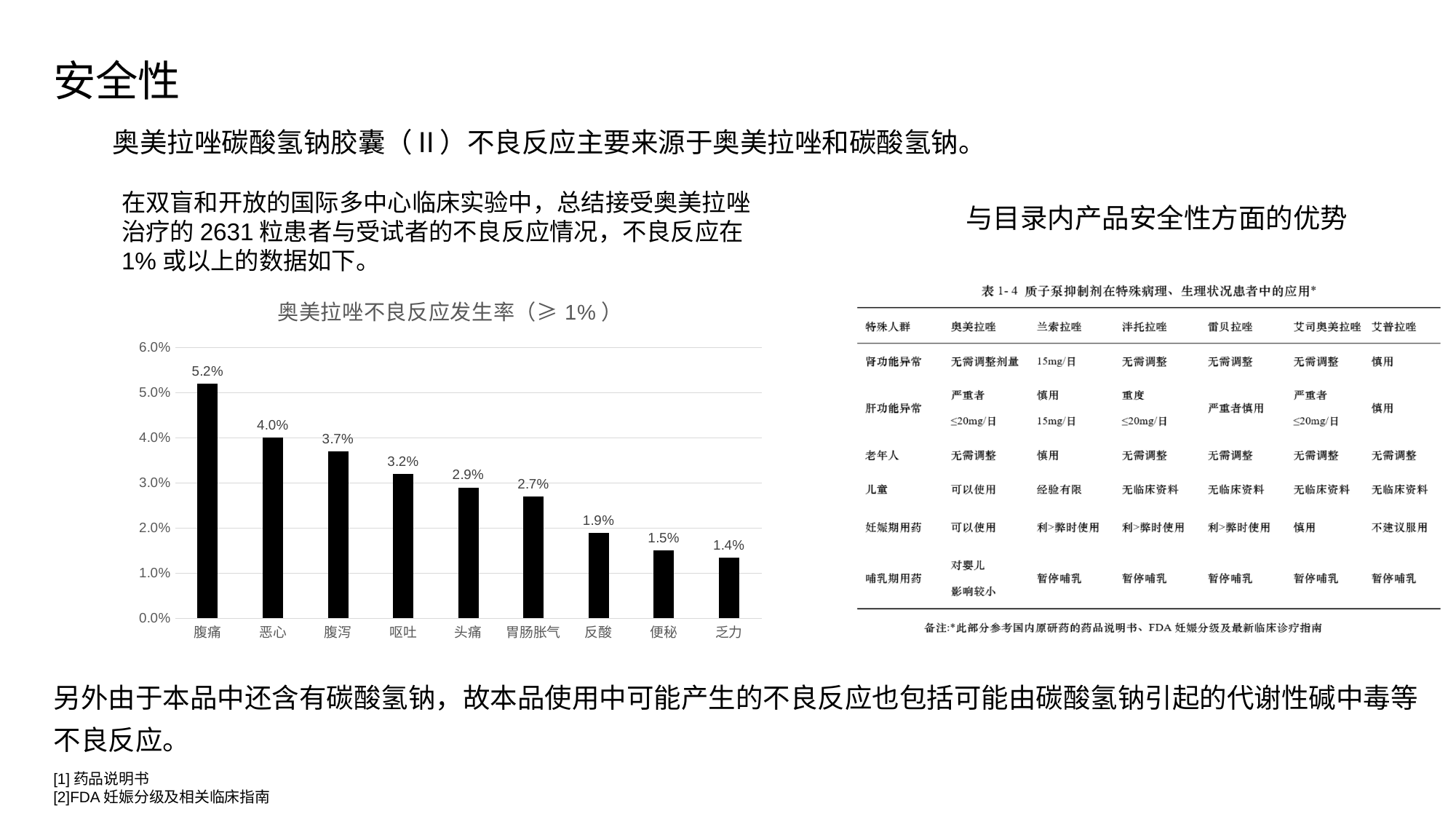
Which adverse reaction has the lowest incidence rate in the chart? 乏力 What is the difference between the incidence rates for 腹痛 and 恶心? 1.2% What is the difference between the incidence rates for 呕吐 and 反酸? 1.3% What is the incidence rate for 头痛 in the chart? 2.9% What is the title of the chart? 奥美拉唑不良反应发生率（≥ 1%） What is the incidence rate for 便秘 in the chart? 1.5% Do the values rise or fall from left to right along the x axis? fall What kind of chart is shown on the slide? bar chart What is the incidence rate for 腹痛 in the chart? 5.2% Which has a higher incidence rate, 腹泻 or 胃肠胀气? 腹泻 How many adverse reaction categories are shown in the chart? 9 Which adverse reaction has the highest incidence rate in the chart? 腹痛